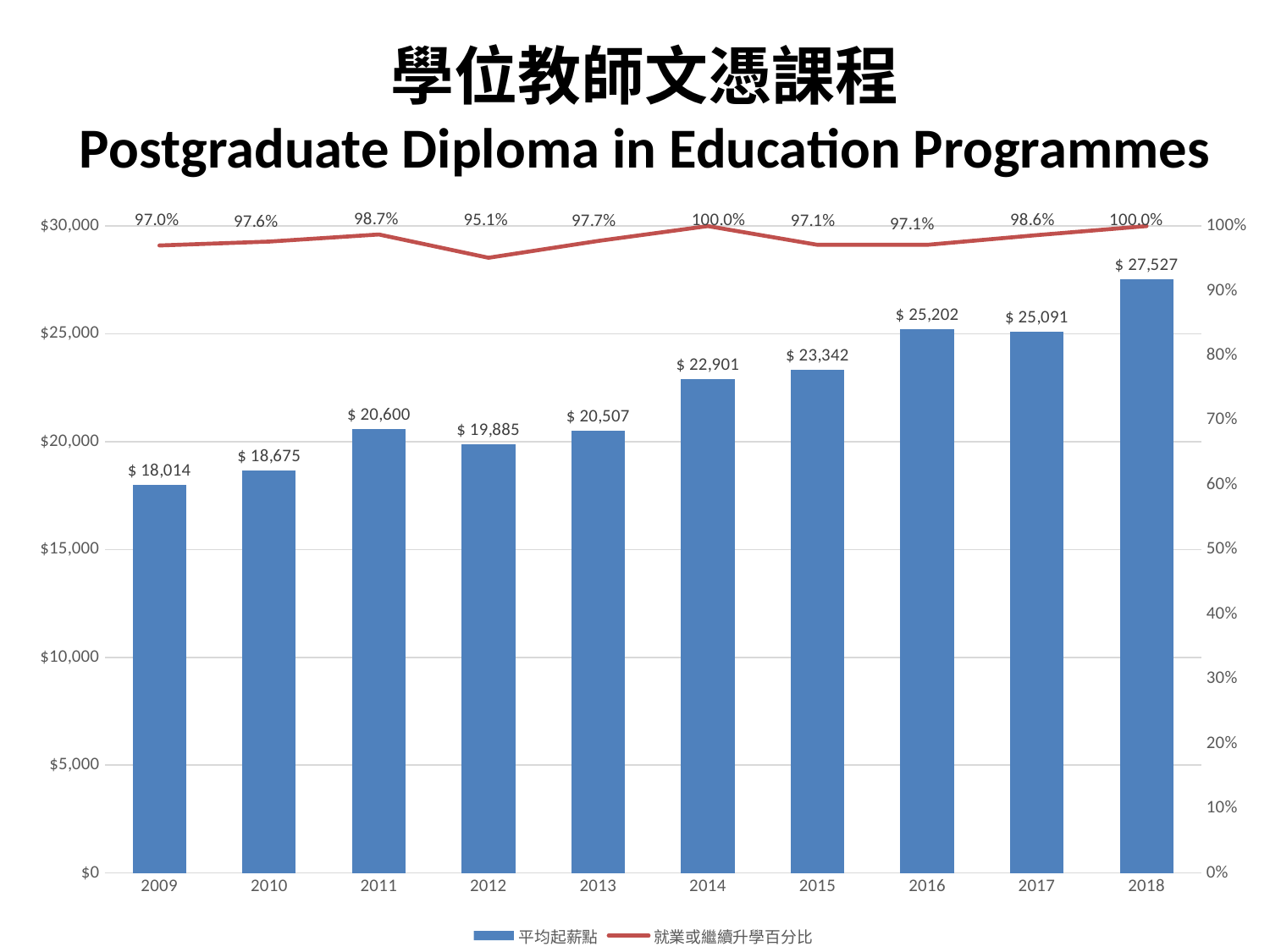
What colour is the line for 就業或繼續升學百分比? Red What is the average starting salary (平均起薪點) shown for 2014? $ 22,901 Which year has the larger average starting salary, 2016 or 2017? 2016 What is the employment or further study percentage (就業或繼續升學百分比) shown for 2012? 95.1% How many series does the legend list? 2 How many years are shown on the x axis? 10 Which year has the lowest employment or further study percentage? 2012 What is the average starting salary shown for 2009? $ 18,014 What is the difference between the average starting salary in 2018 and in 2017? $ 2,436 Which year has the highest average starting salary? 2018 What kind of chart is used to show the average starting salary? Bar chart Do the average starting salary bars generally rise or fall from 2009 to 2018? Rise